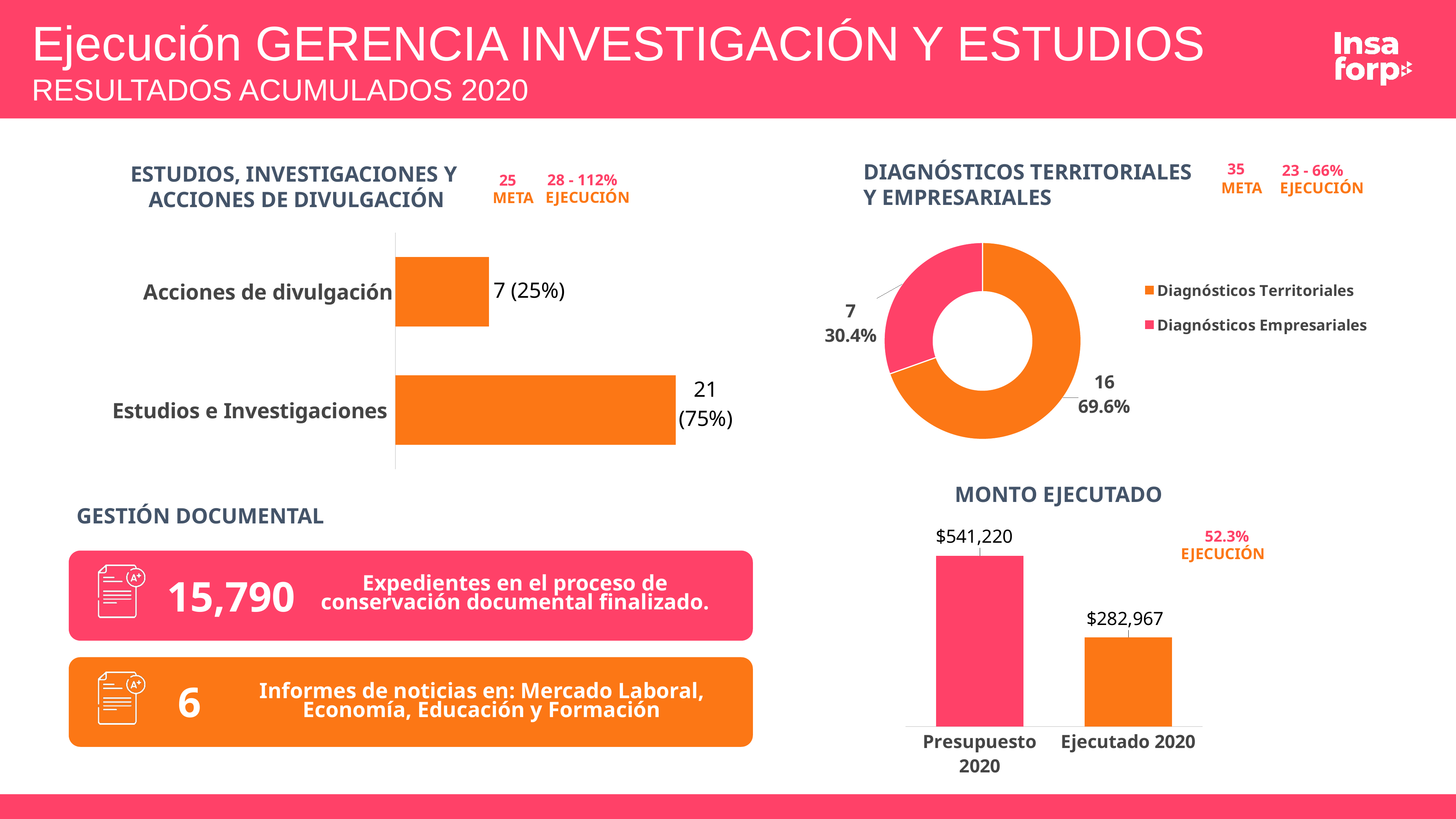
In the 'ESTUDIOS, INVESTIGACIONES Y ACCIONES DE DIVULGACIÓN' chart, which category has the highest value? Estudios e Investigaciones In the 'MONTO EJECUTADO' chart, what is the value for Presupuesto 2020? $541,220 In the 'DIAGNÓSTICOS TERRITORIALES Y EMPRESARIALES' chart, what is the value for Diagnósticos Empresariales? 7 In the 'MONTO EJECUTADO' chart, what is the value for Ejecutado 2020? $282,967 What kind of chart is the 'DIAGNÓSTICOS TERRITORIALES Y EMPRESARIALES' chart? Donut chart In the 'ESTUDIOS, INVESTIGACIONES Y ACCIONES DE DIVULGACIÓN' chart, what is the difference between Estudios e Investigaciones and Acciones de divulgación? 14 In the 'MONTO EJECUTADO' chart, which is larger, Presupuesto 2020 or Ejecutado 2020? Presupuesto 2020 In the 'ESTUDIOS, INVESTIGACIONES Y ACCIONES DE DIVULGACIÓN' chart, what is the value for Acciones de divulgación? 7 (25%) In the 'ESTUDIOS, INVESTIGACIONES Y ACCIONES DE DIVULGACIÓN' chart, what is the value for Estudios e Investigaciones? 21 (75%) What kind of chart is the 'ESTUDIOS, INVESTIGACIONES Y ACCIONES DE DIVULGACIÓN' chart? Bar chart In the 'DIAGNÓSTICOS TERRITORIALES Y EMPRESARIALES' chart, what share of the total is Diagnósticos Territoriales? 69.6% How many entries does the legend of the 'DIAGNÓSTICOS TERRITORIALES Y EMPRESARIALES' chart list? 2